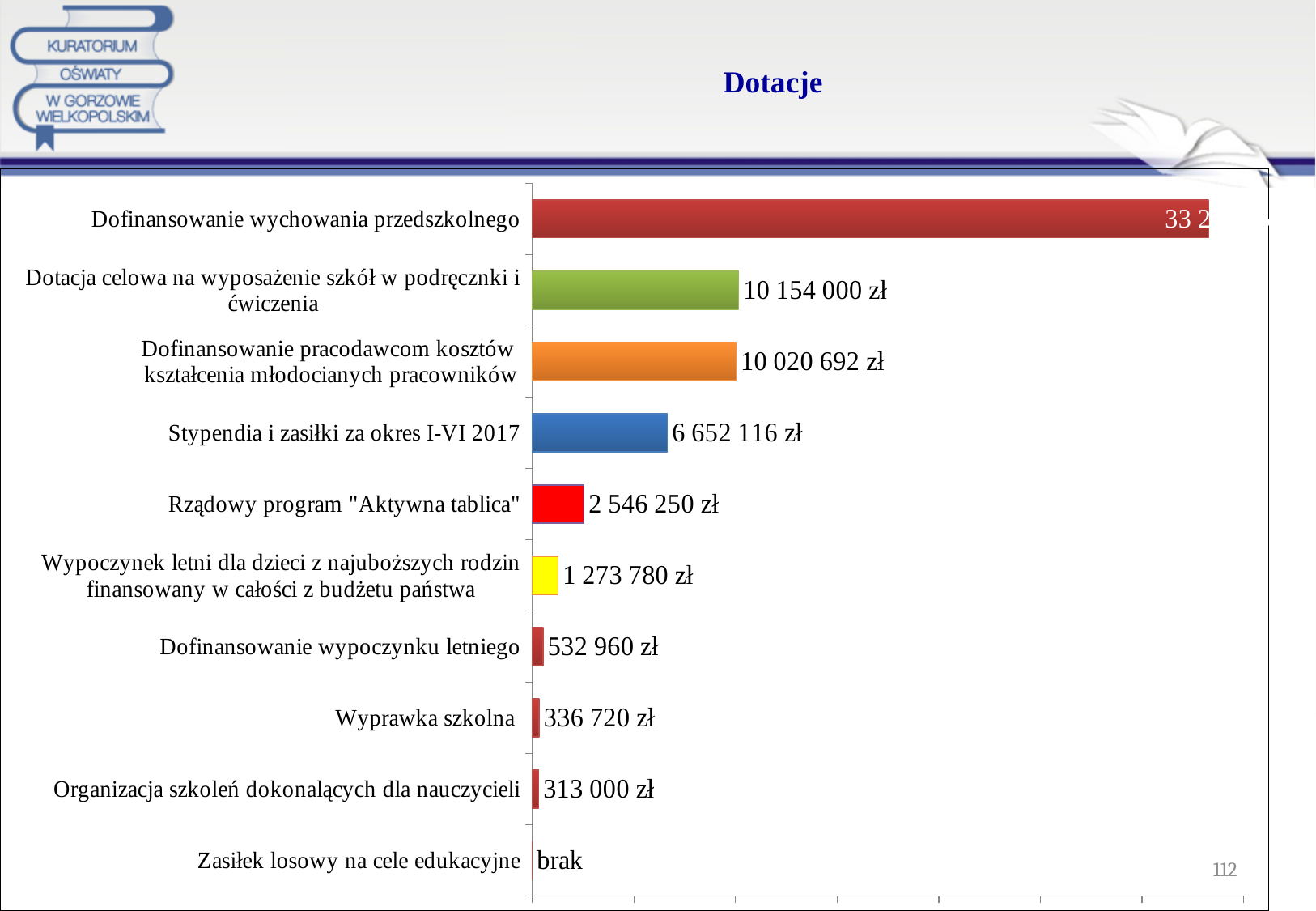
What is the value for "Wyprawka szkolna"? 336 720 zł Which category has the largest bar? Dofinansowanie wychowania przedszkolnego Which is larger: "Dofinansowanie wypoczynku letniego" or "Organizacja szkoleń dokonalących dla nauczycieli"? Dofinansowanie wypoczynku letniego What kind of chart is shown on the slide? bar chart What is the difference between "Dotacja celowa na wyposażenie szkół w podręczniki i ćwiczenia" and "Dofinansowanie pracodawcom kosztów kształcenia młodocianych pracowników"? 133 308 zł What is the title of the chart? Dotacje What is the value for "Rządowy program "Aktywna tablica""? 2 546 250 zł What is the value for "Dotacja celowa na wyposażenie szkół w podręczniki i ćwiczenia"? 10 154 000 zł What is the value for "Dofinansowanie pracodawcom kosztów kształcenia młodocianych pracowników"? 10 020 692 zł What is the value for "Stypendia i zasiłki za okres I-VI 2017"? 6 652 116 zł How many categories are listed on the chart? 10 What is shown as the value for "Zasiłek losowy na cele edukacyjne"? brak